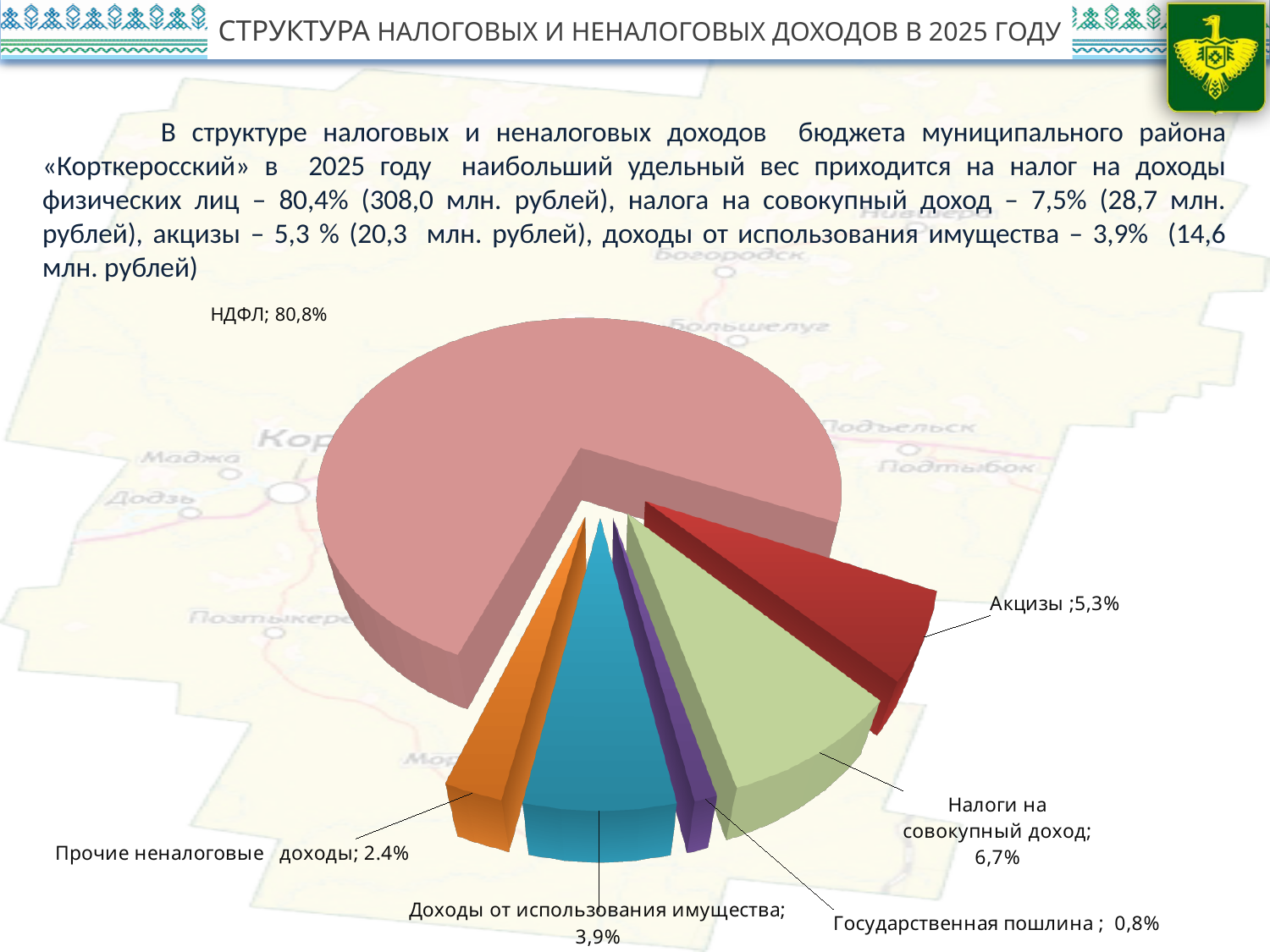
Which category has the smallest slice of the pie? Государственная пошлина What kind of chart is shown on the slide? Pie chart How many slices does the pie chart have? 6 Which is larger: Акцизы or Налоги на совокупный доход? Налоги на совокупный доход What is the difference between the shares of Налоги на совокупный доход and Акцизы? 1,4% What is the value shown for Государственная пошлина? 0,8% What is the value shown for Акцизы? 5,3% What is the value shown for Налоги на совокупный доход? 6,7% What share of the pie does НДФЛ account for? 80,8% Which category has the largest slice of the pie? НДФЛ What is the value shown for Доходы от использования имущества? 3,9% What is the value shown for Прочие неналоговые доходы? 2.4%